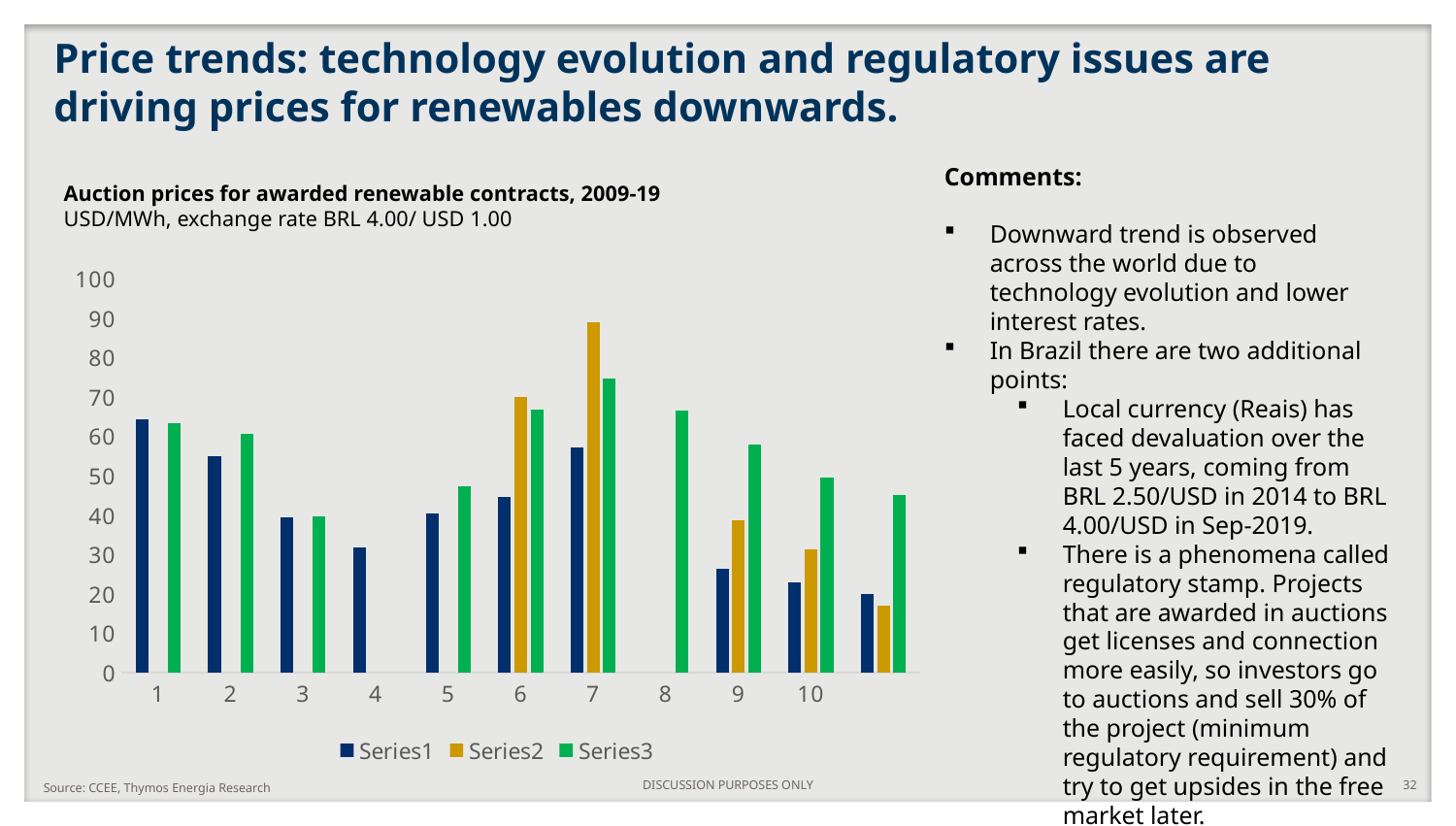
Does the Series1 value generally rise or fall from category 1 to category 10? fall What is the title of the chart? Auction prices for awarded renewable contracts, 2009-19 Is the Series2 value for category 6 greater or less than 60? greater What kind of chart is shown on the slide? Bar chart Is the Series2 value for category 7 greater or less than 80? greater How many series does the chart legend list? 3 Is the Series3 value for category 8 greater or less than 60? greater What unit is the chart's y axis measured in, according to the subtitle? USD/MWh Which is larger at category 7: the Series2 value or the Series3 value? Series2 Which category has the highest Series2 bar? 7